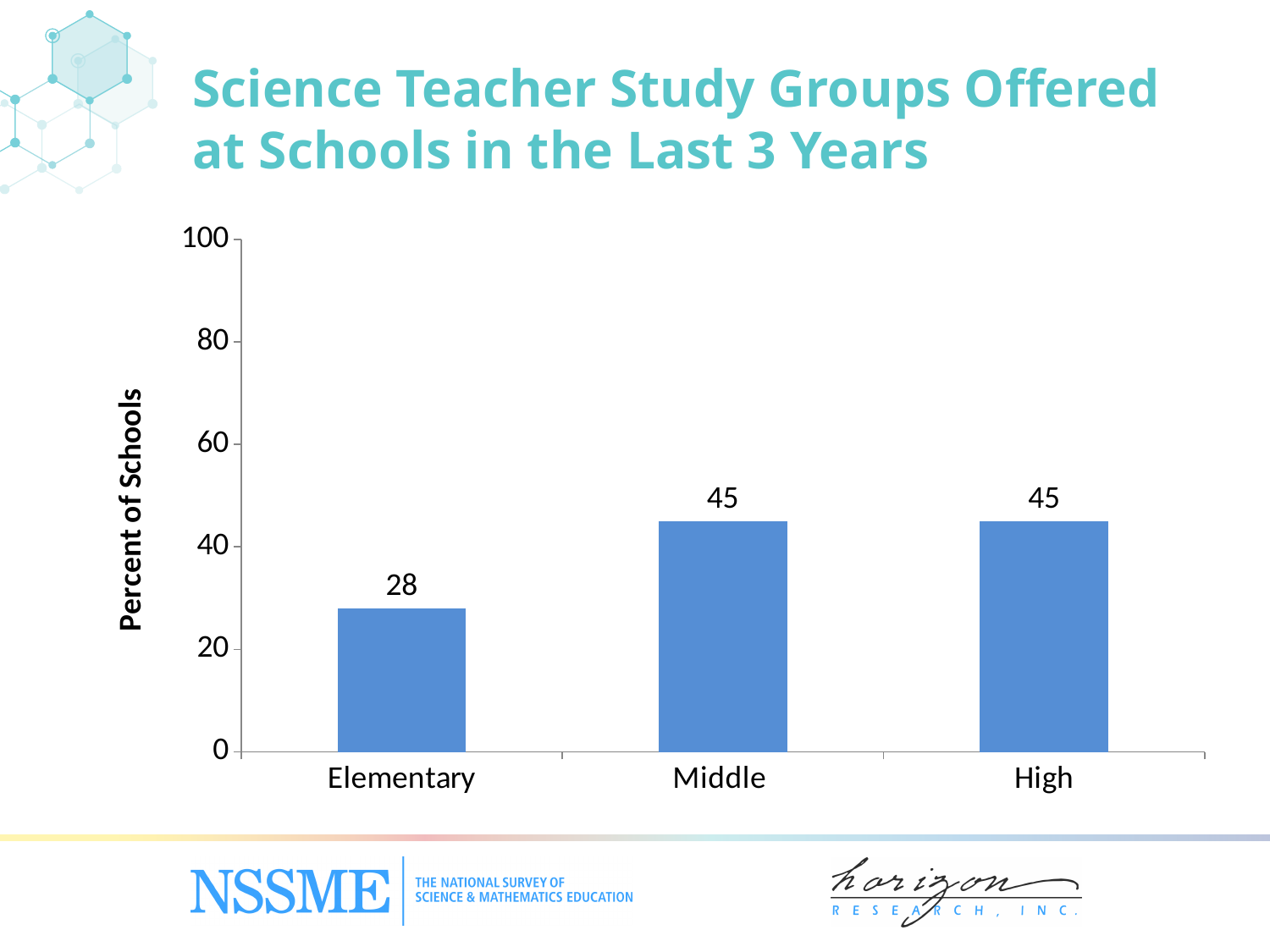
Which category has the lowest value? Elementary What is the value for Elementary? 28 What kind of chart is shown on the slide? bar chart What is the difference between the values for Middle and Elementary? 17 Which is larger, the value for Elementary or the value for High? High What is the label of the vertical axis? Percent of Schools What is the value for Middle? 45 How many categories are shown on the x axis? 3 What is the value for High? 45 What is the title of the chart? Science Teacher Study Groups Offered at Schools in the Last 3 Years Is the value for Elementary greater or less than 40? less Is the value for Middle greater or less than 40? greater